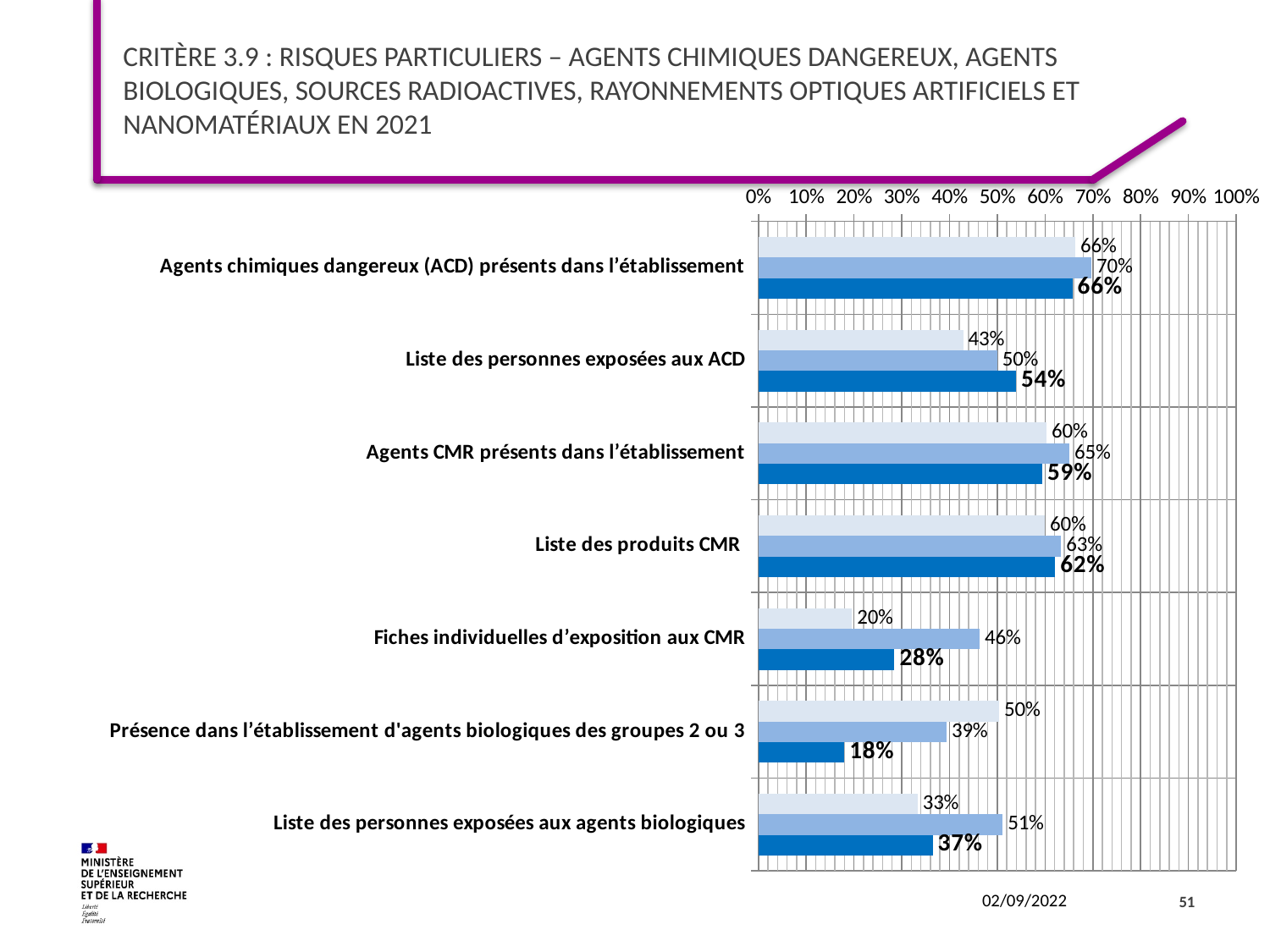
What is the value of the dark blue (bottom) bar for 'Liste des personnes exposées aux agents biologiques'? 37% How many bars are shown for each category? 3 What is the difference between the medium blue bar and the light blue bar for 'Fiches individuelles d'exposition aux CMR'? 26% What is the value of the dark blue (bottom) bar for 'Liste des personnes exposées aux ACD'? 54% What is the value of the light blue (top) bar for 'Présence dans l'établissement d'agents biologiques des groupes 2 ou 3'? 50% Which category has the highest value for the dark blue (bottom) bar? Agents chimiques dangereux (ACD) présents dans l'établissement For 'Présence dans l'établissement d'agents biologiques des groupes 2 ou 3', which is larger: the light blue bar or the dark blue bar? the light blue bar How many categories are shown on the chart? 7 Is the dark blue bar for 'Agents CMR présents dans l'établissement' greater or less than 50%? greater What type of chart is shown on the slide? bar chart What is the value of the medium blue (middle) bar for 'Fiches individuelles d'exposition aux CMR'? 46% Which category has the lowest value for the dark blue (bottom) bar? Présence dans l'établissement d'agents biologiques des groupes 2 ou 3